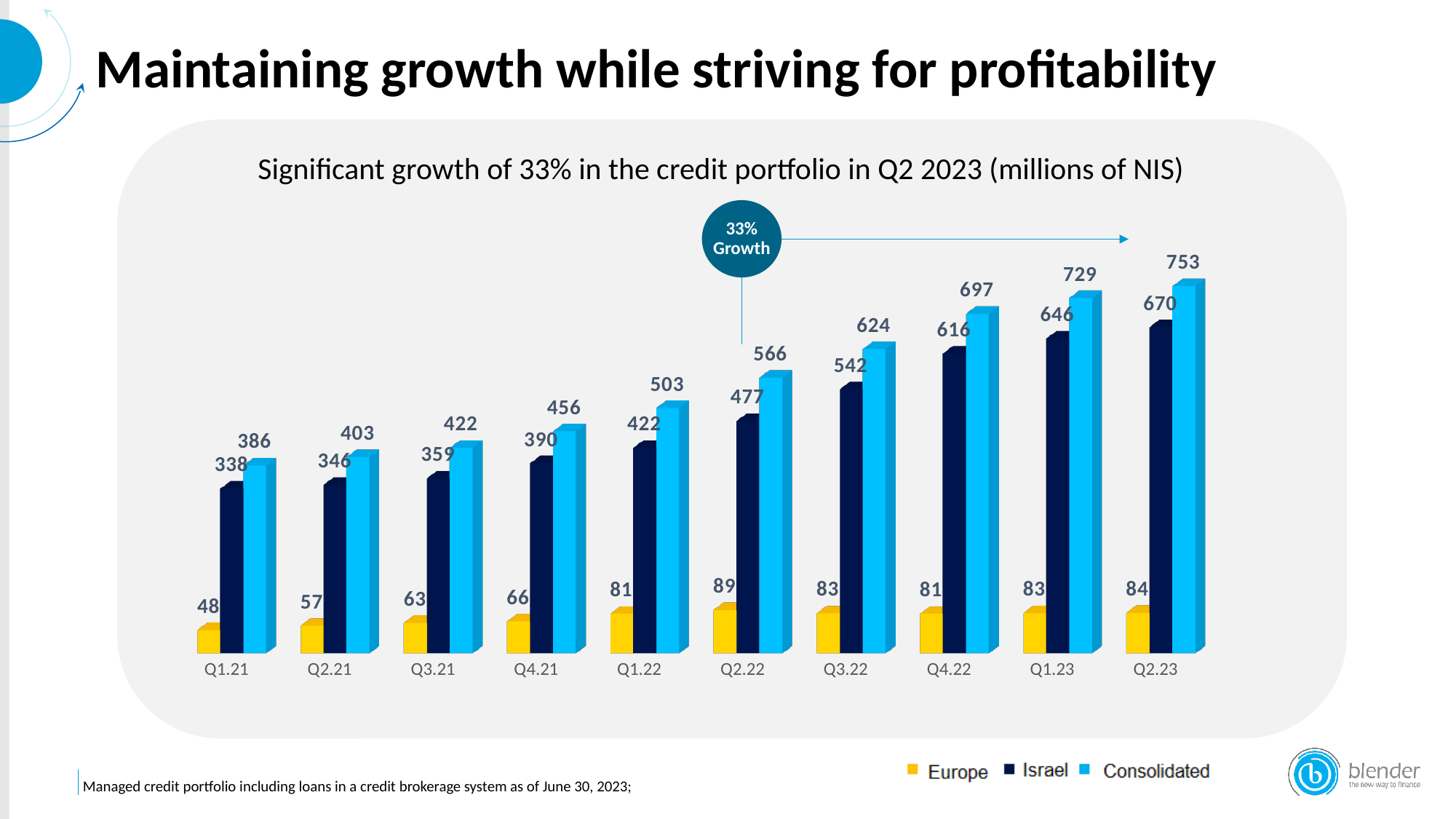
Which quarter has the highest Consolidated value? Q2.23 How many quarters are shown on the x axis? 10 Do the Consolidated values rise or fall from Q1.21 to Q2.23? Rise Which quarter has the lowest Europe value? Q1.21 What growth percentage is highlighted in the circle above the chart? 33% Growth What kind of chart is shown on the slide? Bar chart What is the Israel value for Q1.21? 338 How many series does the legend list? 3 Which is larger, the Israel value for Q4.22 or the Israel value for Q1.23? Q1.23 What is the Europe value for Q2.22? 89 What is the difference between the Consolidated values for Q2.23 and Q2.22? 187 What is the Consolidated value for Q2.23? 753